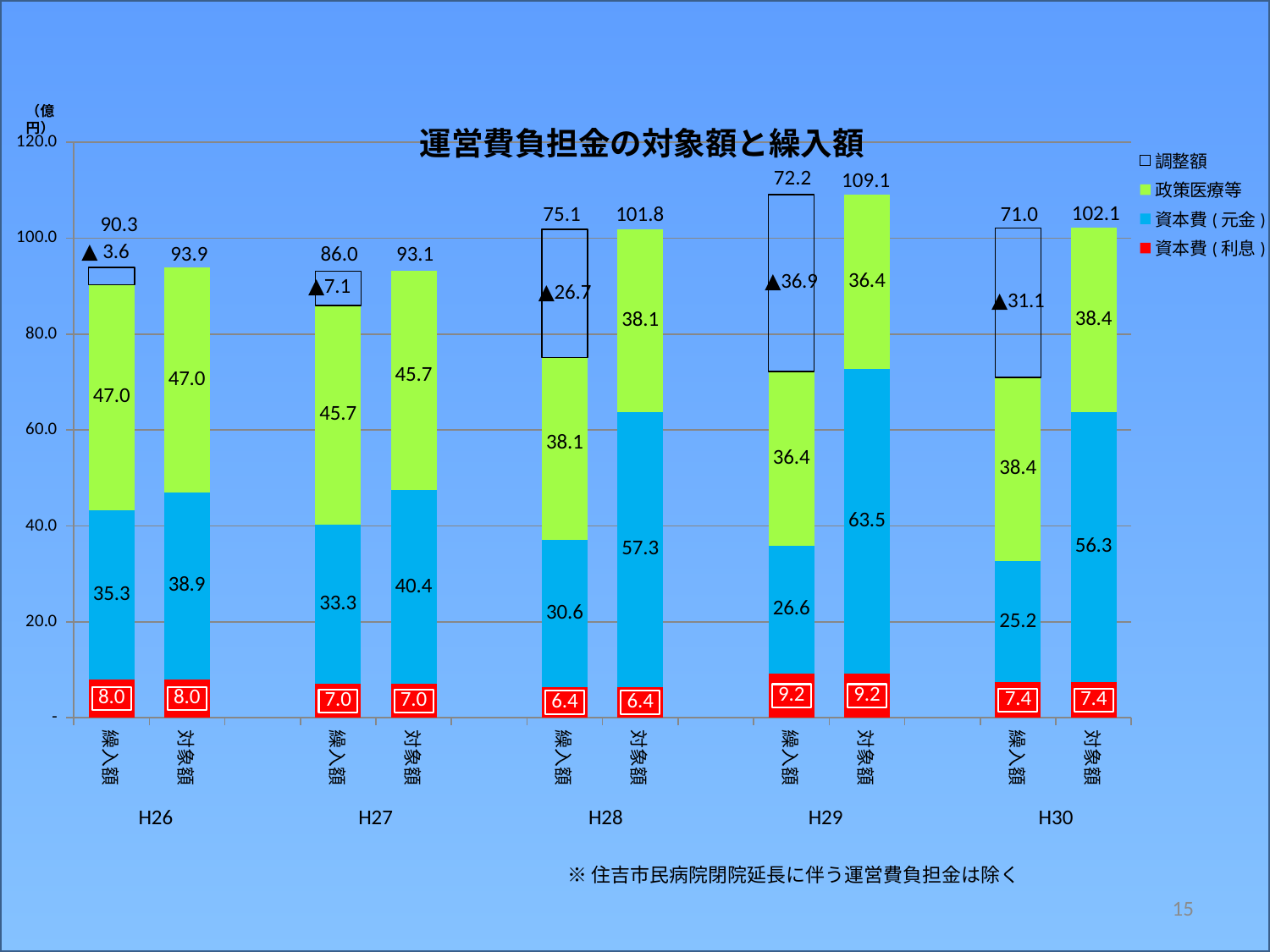
What is the title of the chart? 運営費負担金の対象額と繰入額 What is the 政策医療等 value for the 繰入額 bar in H27? 45.7 Which year has the lowest 繰入額 total? H30 What is the total labelled above the 対象額 bar for H29? 109.1 Which year has the highest 対象額 total? H29 What is the 資本費(元金) value for the 対象額 bar in H28? 57.3 How many series does the legend list? 4 What is the difference between the 対象額 total and the 繰入額 total in H28? 26.7 What is the 調整額 value shown for the 繰入額 bar in H30? ▲31.1 What type of chart is shown on the slide? stacked bar chart Which is larger, the 資本費(元金) value for 対象額 in H27 or for 対象額 in H30? 対象額 in H30 What is the 資本費(利息) value for the 繰入額 bar in H29? 9.2